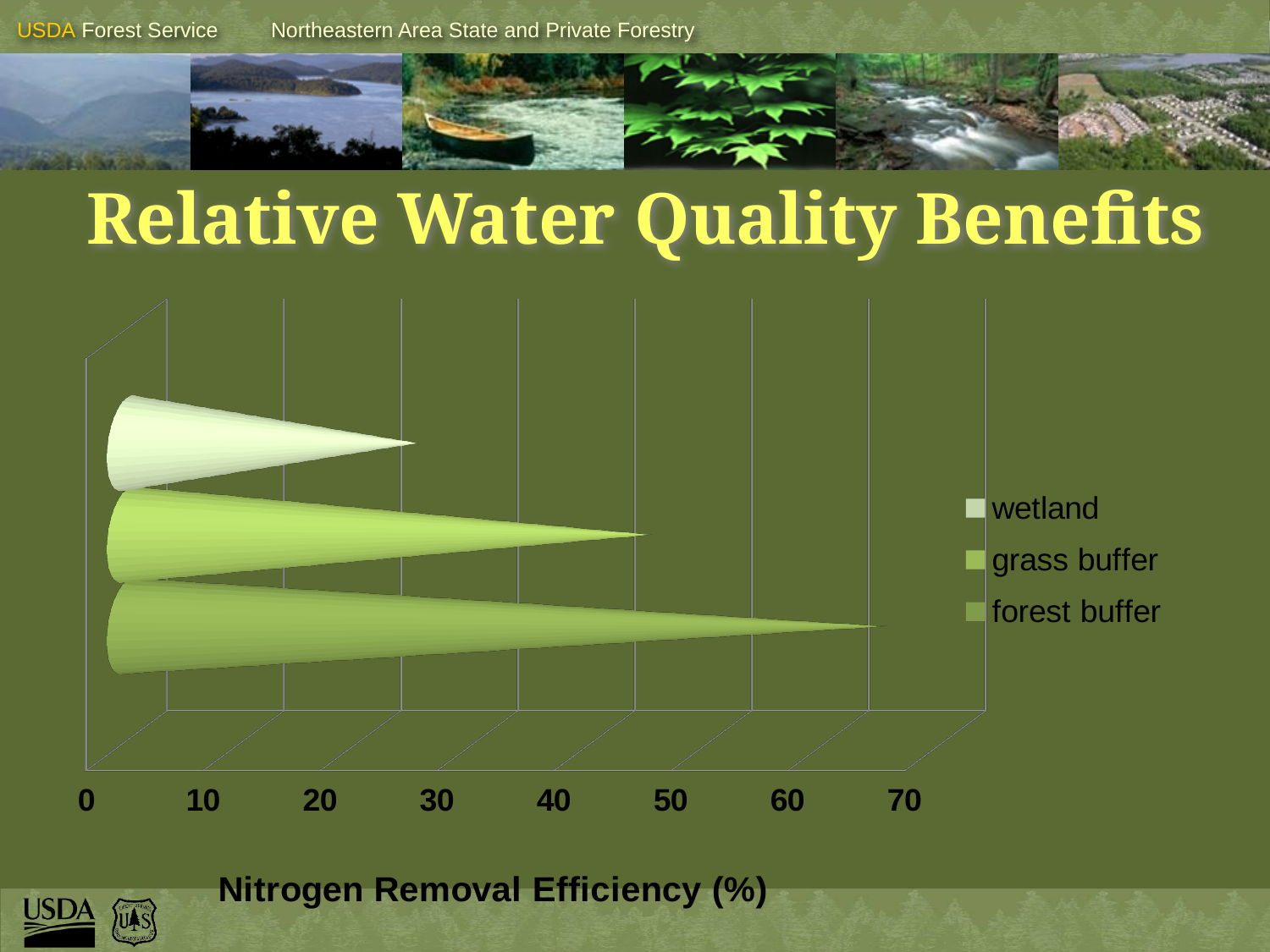
Is the value for forest buffer greater or less than 60? greater Which series has the lowest nitrogen removal efficiency? wetland Which has a larger value, grass buffer or wetland? grass buffer How many series does the legend list? 3 What is the title of the chart on the slide? Relative Water Quality Benefits Is the value for grass buffer greater or less than 30? greater Is the value for wetland greater or less than 40? less Which has a larger value, forest buffer or grass buffer? forest buffer Which series has the highest nitrogen removal efficiency? forest buffer What kind of chart is shown on the slide? bar chart What is the label of the horizontal axis? Nitrogen Removal Efficiency (%) How many bars are plotted in the chart? 3